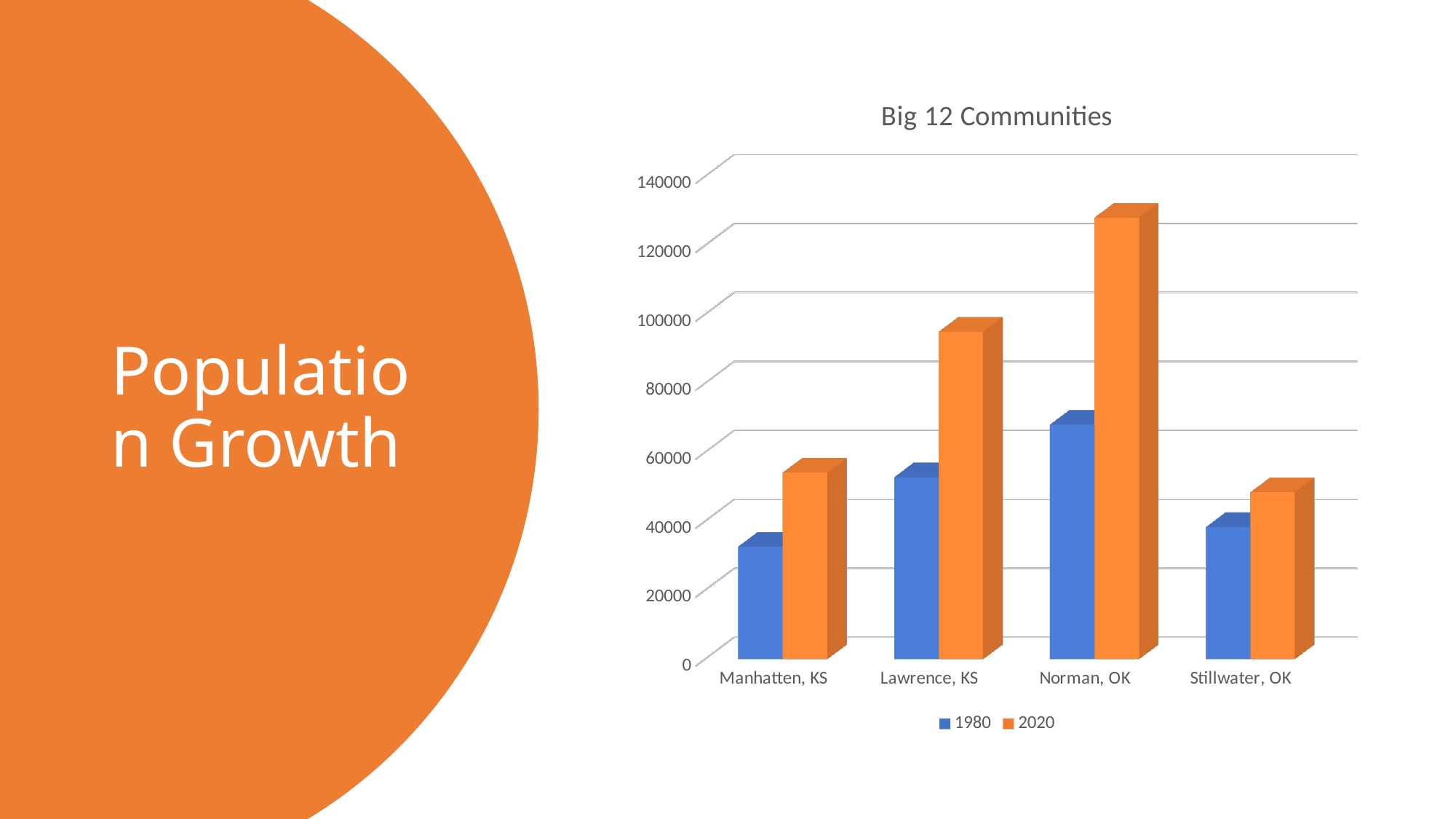
How many series does the legend list? 2 Is the 2020 value for Norman, OK greater or less than 120000? greater Which is larger, the 2020 value for Lawrence, KS or the 2020 value for Norman, OK? Norman, OK How many communities are shown on the x axis? 4 Which community has the highest 2020 value? Norman, OK Is the 2020 value for Lawrence, KS greater or less than 80000? greater What is the title of the chart? Big 12 Communities Which series is shown in orange? 2020 Which community has the lowest 1980 value? Manhatten, KS Is the 2020 value for Stillwater, OK greater or less than 60000? less What kind of chart is shown on the slide? Bar chart